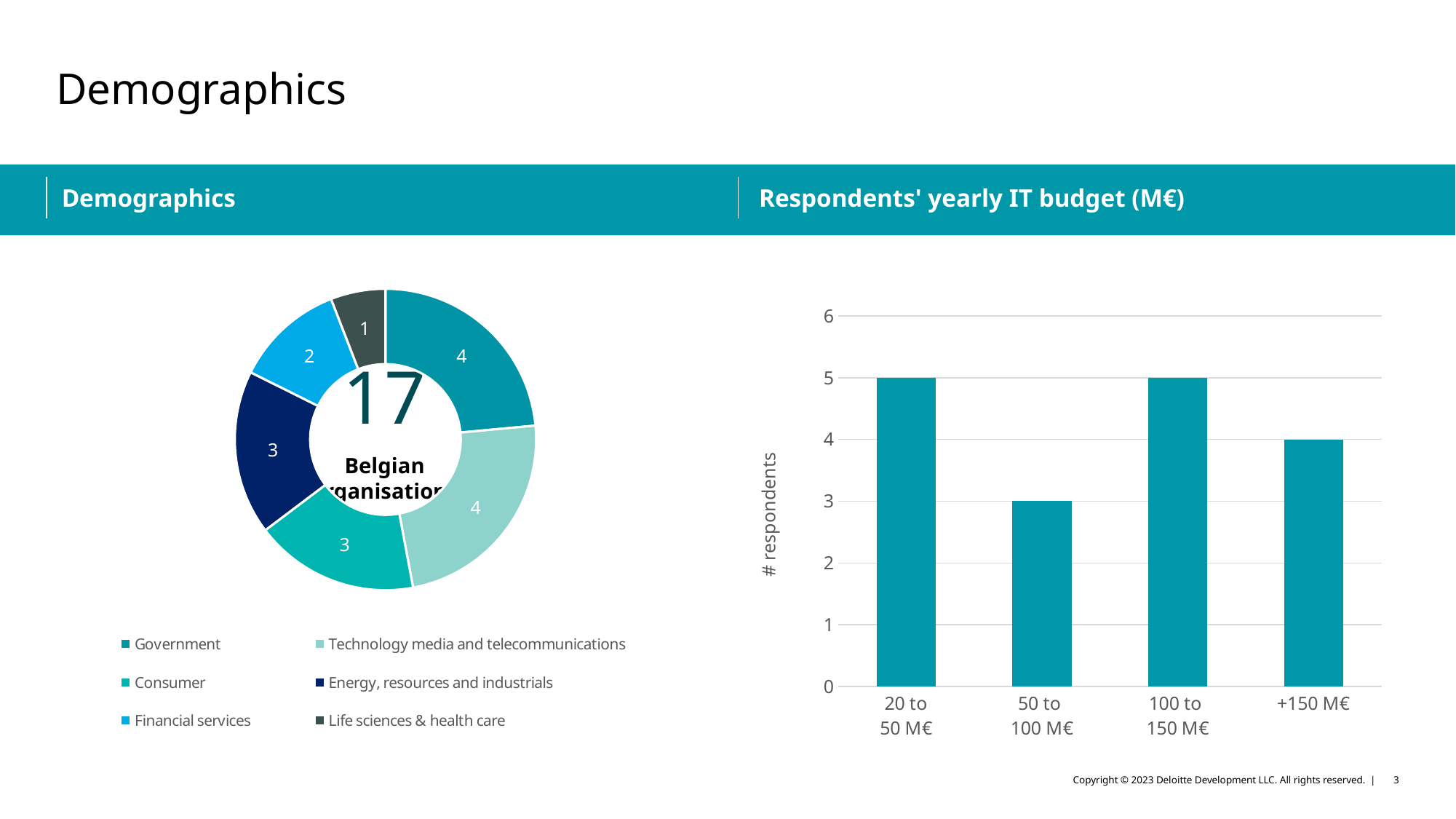
In the Demographics donut chart, which sector has the fewest respondents? Life sciences & health care In the Demographics donut chart, how many respondents are from Government? 4 In the Respondents' yearly IT budget chart, how many respondents have a budget of 50 to 100 M€? 3 In the Respondents' yearly IT budget chart, how many budget categories are shown on the x axis? 4 In the Demographics donut chart, what is the difference between the Energy, resources and industrials count and the Life sciences & health care count? 2 In the Respondents' yearly IT budget chart, which has more respondents: 20 to 50 M€ or +150 M€? 20 to 50 M€ In the Respondents' yearly IT budget chart, which budget range has the fewest respondents? 50 to 100 M€ What type of chart is the Respondents' yearly IT budget chart? Bar chart In the Demographics donut chart, how many sectors does the legend list? 6 In the Demographics donut chart, how many respondents are from Financial services? 2 In the Respondents' yearly IT budget chart, how many respondents have a budget of +150 M€? 4 In the Demographics donut chart, what is the total number of Belgian organisations shown in the centre? 17